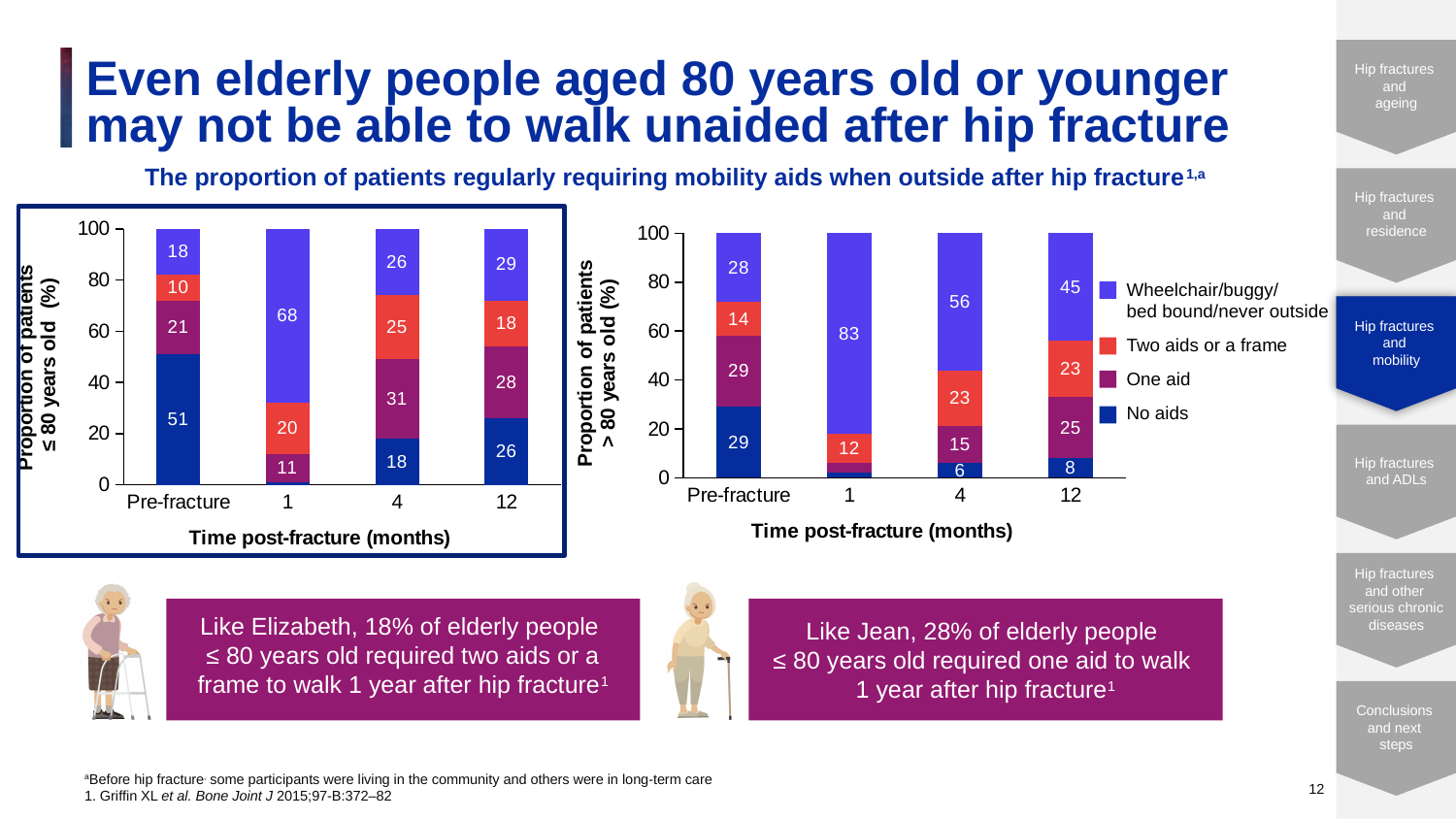
How many series does the legend list? 4 In the left chart (≤ 80 years old), what is the difference between the No aids value pre-fracture and at 12 months? 25 In the right chart (> 80 years old), what percentage of patients used no aids at 12 months post-fracture? 8 In the right chart (> 80 years old), what is the total of the stacked bar at 4 months post-fracture? 100 In the left chart (≤ 80 years old), what is the value for the Wheelchair/buggy/bed bound/never outside segment at 1 month post-fracture? 68 In the left chart (≤ 80 years old), what percentage of patients used no aids pre-fracture? 51 In the right chart (> 80 years old), which time point has the lowest Wheelchair/buggy/bed bound/never outside value? Pre-fracture What type of chart is used on this slide? Stacked bar chart In the right chart (> 80 years old), what is the value for the Wheelchair/buggy/bed bound/never outside segment at 1 month post-fracture? 83 In the left chart (≤ 80 years old), which time point has the highest No aids value? Pre-fracture How many time points are shown on the x axis of the left chart (≤ 80 years old)? 4 In the right chart (> 80 years old), which is larger at 4 months: the Two aids or a frame value or the One aid value? Two aids or a frame